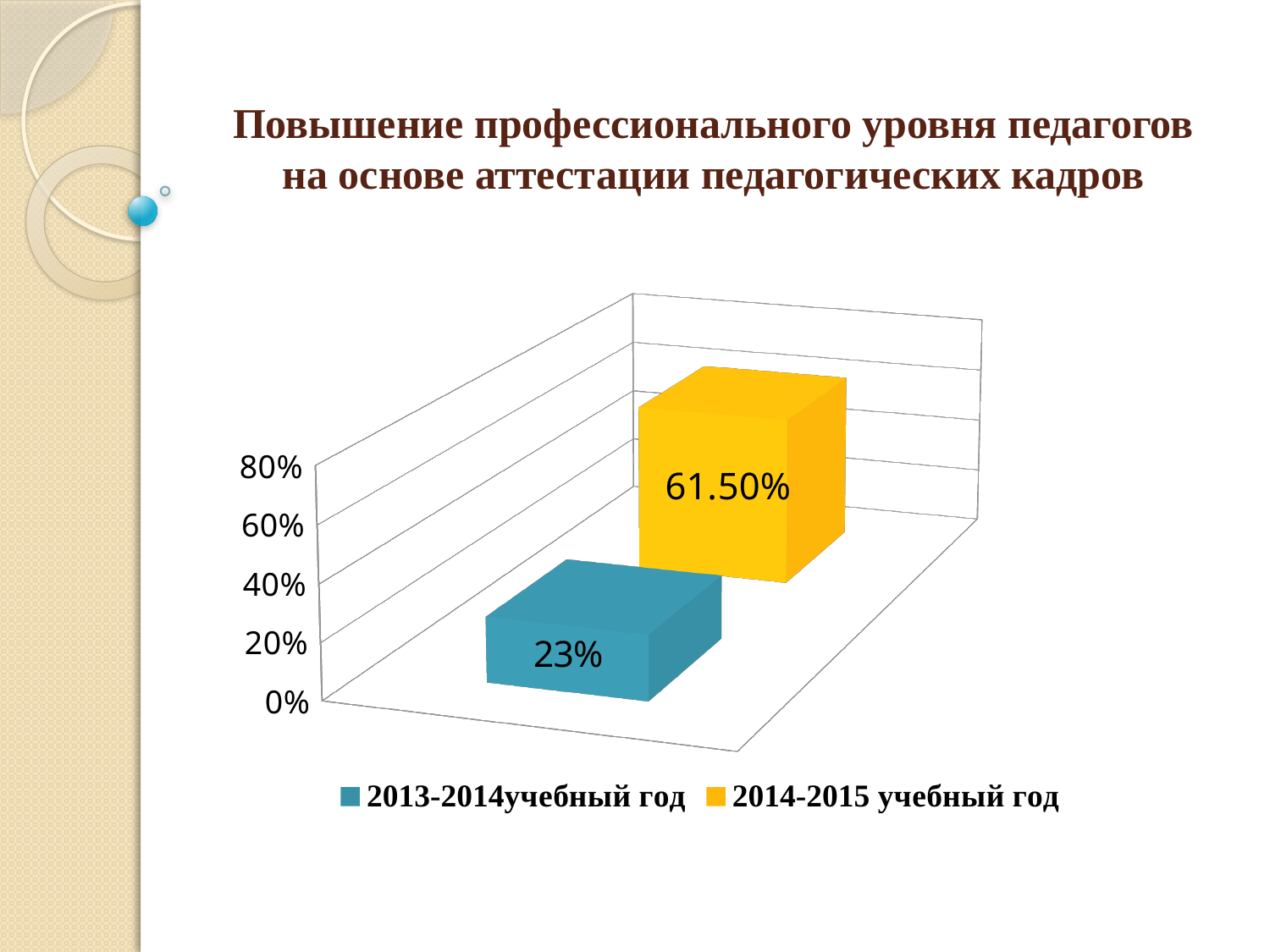
What is the highest value shown on the vertical axis? 80% What is the value for 2014-2015 учебный год? 61.50% Is the value for 2013-2014 учебный год greater or less than 40%? less What is the value for 2013-2014 учебный год? 23% How many series does the legend list? 2 What kind of chart is shown on the slide? bar chart What is the difference between the values for 2014-2015 учебный год and 2013-2014 учебный год? 38.50% Which series has the lowest value? 2013-2014 учебный год What colour is the bar for 2014-2015 учебный год? yellow Which series has the highest value? 2014-2015 учебный год Which series has the higher value, 2013-2014 учебный год or 2014-2015 учебный год? 2014-2015 учебный год Is the value for 2014-2015 учебный год greater or less than 40%? greater